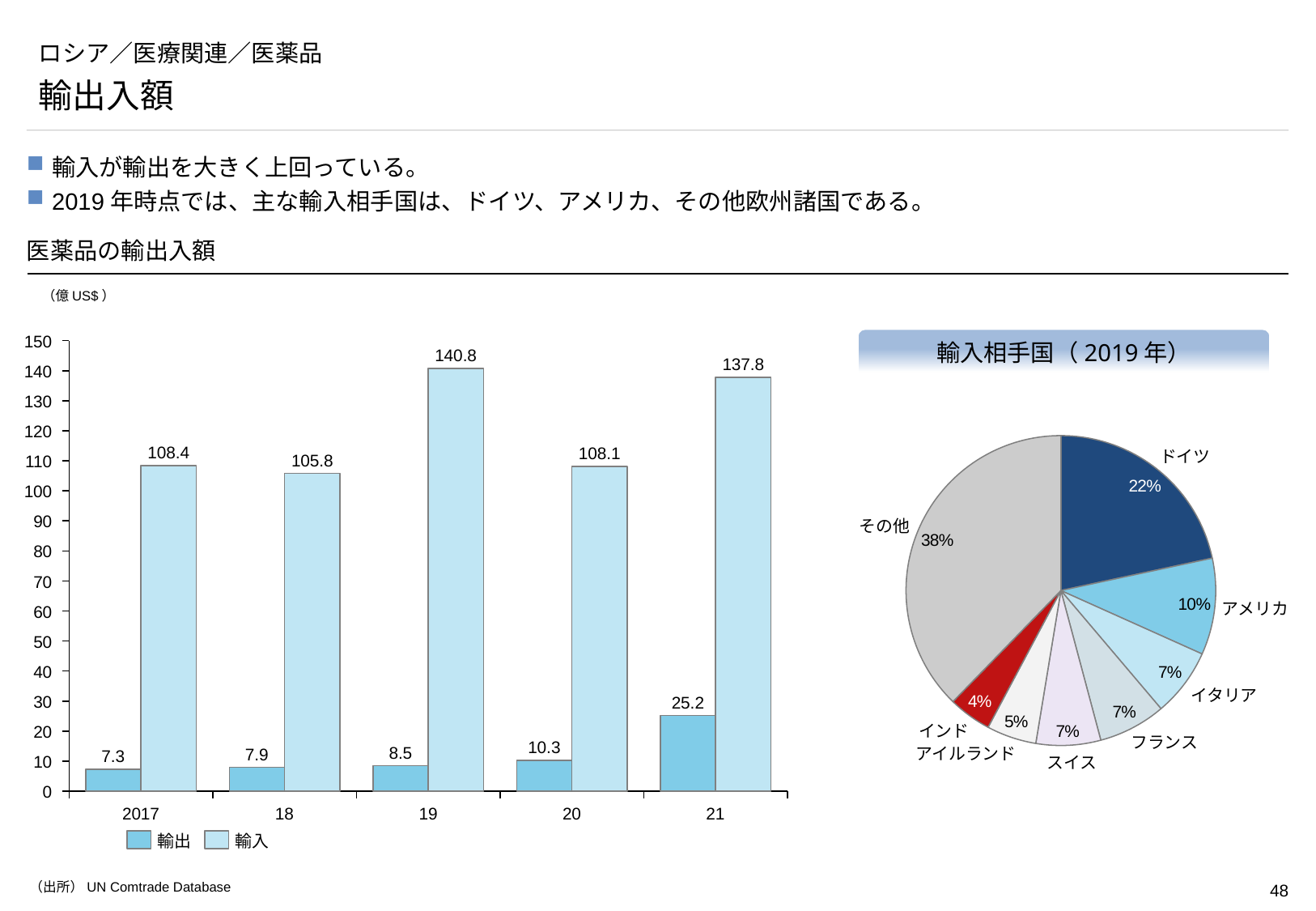
In the bar chart 医薬品の輸出入額, what is the value of 輸出 for 2017? 7.3 What kind of chart is 輸入相手国（2019年）? Pie chart In the bar chart 医薬品の輸出入額, how many series does the legend list? 2 In the bar chart 医薬品の輸出入額, is the 輸入 value for 20 larger than the 輸入 value for 2017? No In the bar chart 医薬品の輸出入額, which year has the lowest 輸入 value? 18 In the pie chart 輸入相手国（2019年）, which named country (excluding その他) has the smallest share? インド In the bar chart 医薬品の輸出入額, what is the difference between 輸入 and 輸出 for 21? 112.6 In the pie chart 輸入相手国（2019年）, what share does ドイツ have? 22% In the bar chart 医薬品の輸出入額, which year has the highest 輸出 value? 21 In the bar chart 医薬品の輸出入額, what is the value of 輸入 for 19? 140.8 In the pie chart 輸入相手国（2019年）, how many slices are there? 8 In the bar chart 医薬品の輸出入額, do the 輸出 values rise or fall from 2017 to 21? Rise